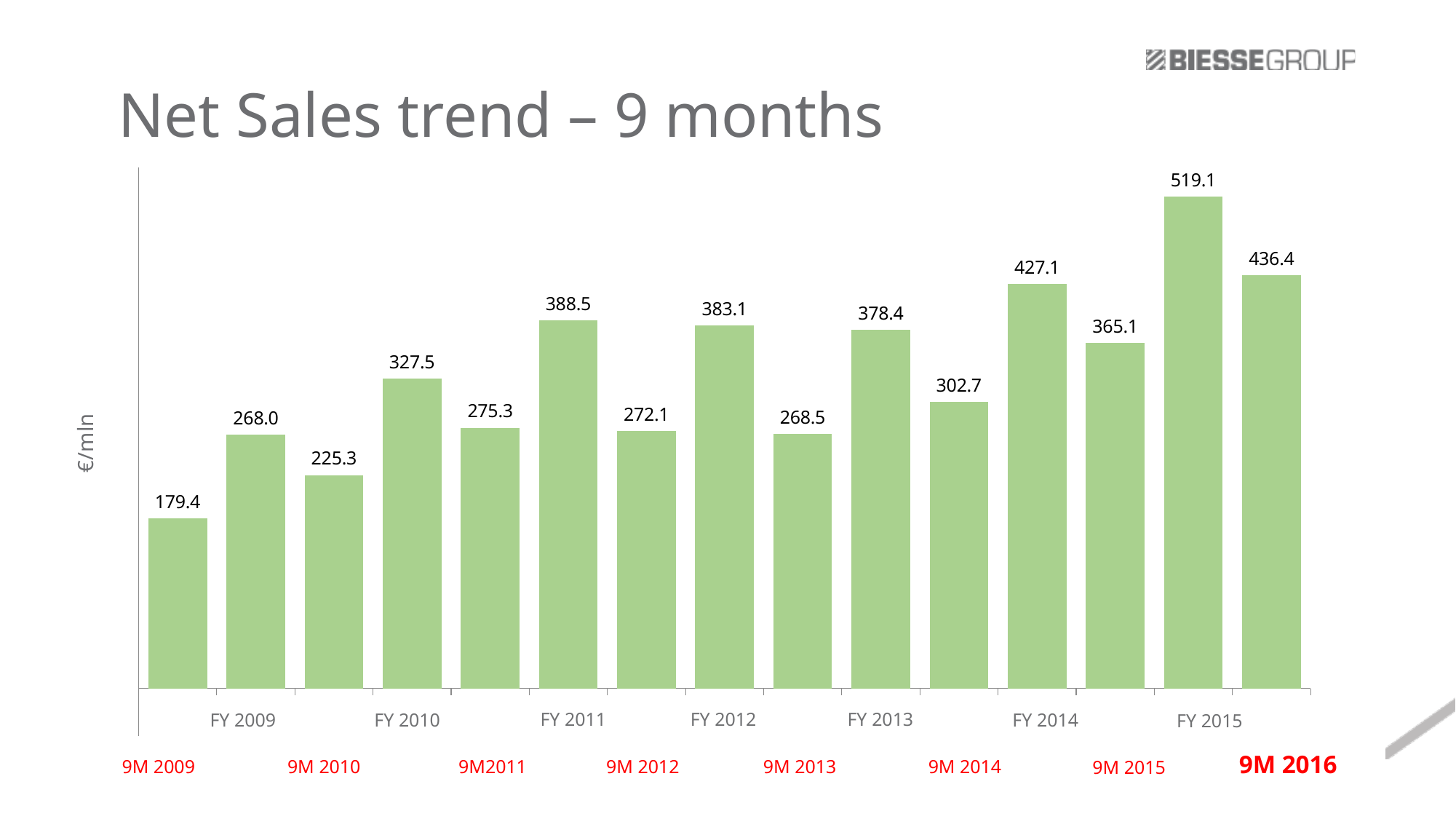
What is the difference between the net sales for 9M 2016 and 9M 2015? 71.3 What is the difference between the net sales for FY 2015 and FY 2014? 92.0 What is the net sales value for 9M 2016? 436.4 What kind of chart is shown on the slide? Bar chart What is the net sales value for 9M 2009? 179.4 Which period has the highest net sales? FY 2015 Which period has the lowest net sales? 9M 2009 Which is larger, the net sales for FY 2011 or FY 2012? FY 2011 How many bars are plotted in the chart? 15 What unit is shown on the vertical axis label? €/mln What is the net sales value for FY 2015? 519.1 What is the net sales value for FY 2012? 383.1